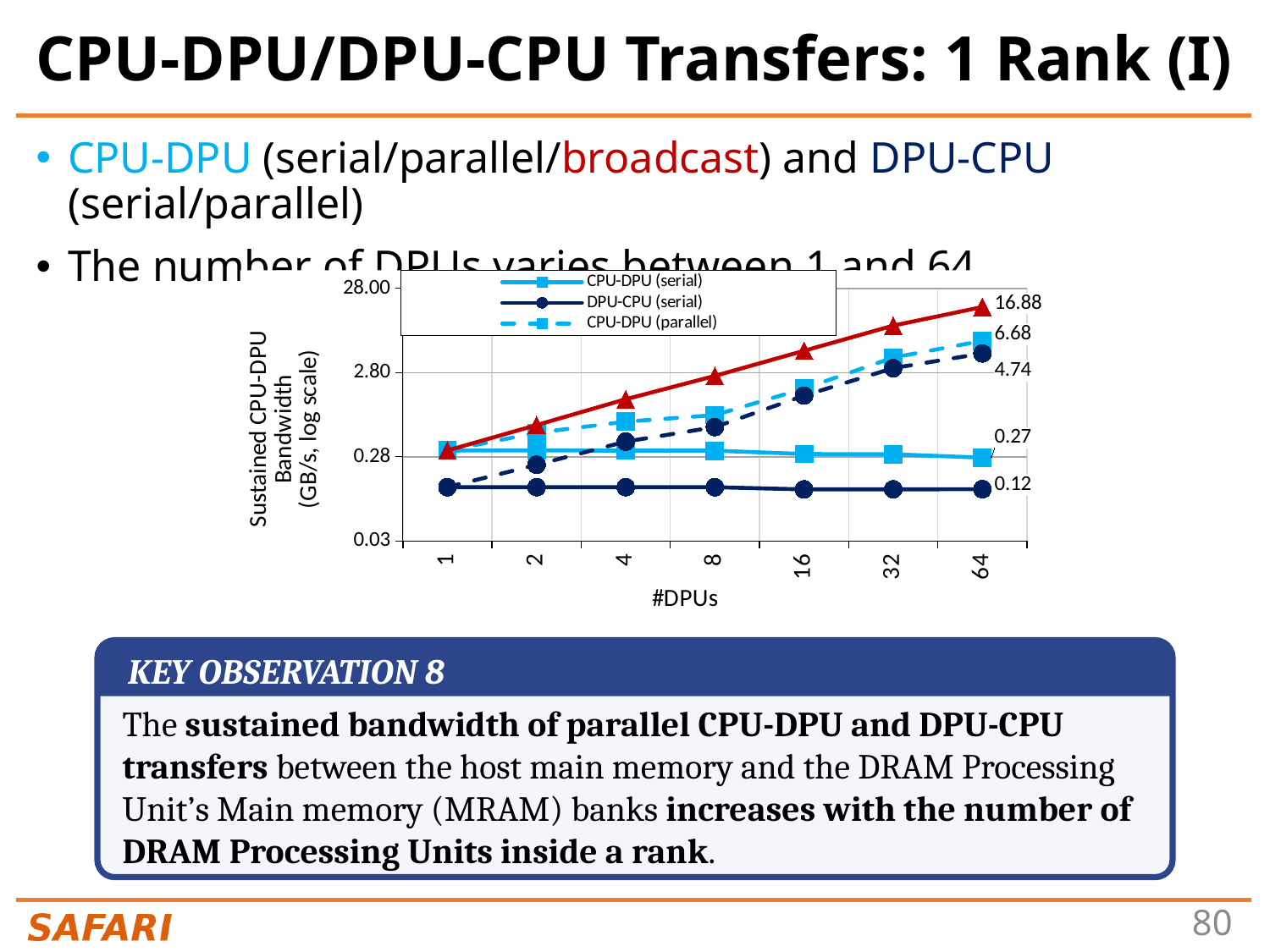
What is the difference between the CPU-DPU (parallel) and CPU-DPU (serial) values at 64 DPUs? 6.41 At 64 DPUs, which is larger: CPU-DPU (parallel) or CPU-DPU (serial)? CPU-DPU (parallel) What is the difference between the CPU-DPU (serial) and DPU-CPU (serial) values at 64 DPUs? 0.15 What kind of chart is shown on the slide? line chart How many #DPUs values are shown along the x axis of the chart? 7 What is the label of the x axis of the chart? #DPUs Among the series named in the legend, which has the lowest value at 64 DPUs? DPU-CPU (serial) Is the value for DPU-CPU (serial) at 1 DPU greater or less than 0.28? less What is the value of CPU-DPU (serial) at 64 DPUs? 0.27 Does the CPU-DPU (parallel) bandwidth rise or fall as the number of DPUs increases? rise What is the value of DPU-CPU (serial) at 64 DPUs? 0.12 What is the value of CPU-DPU (parallel) at 64 DPUs? 6.68